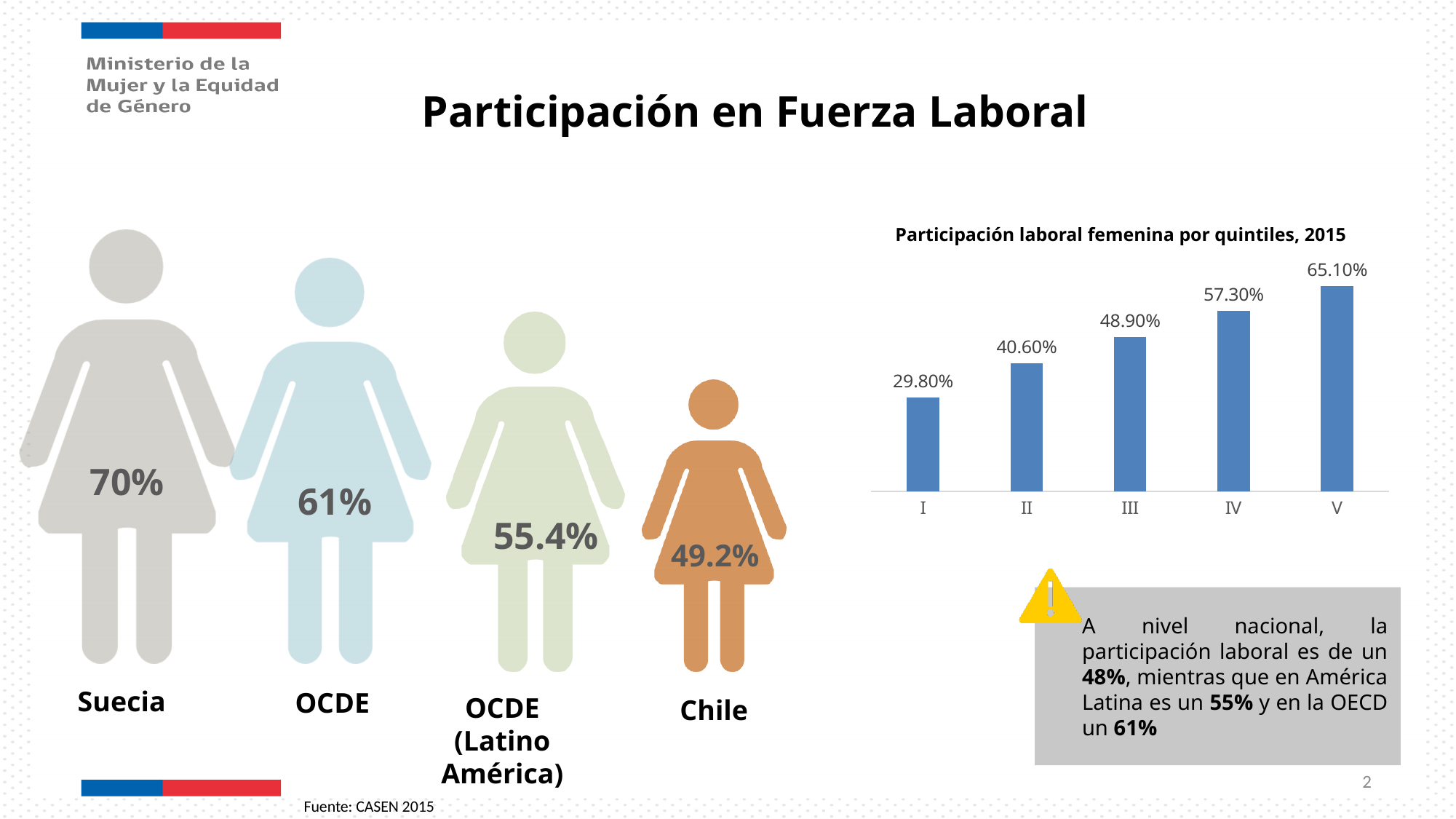
In the chart 'Participación laboral femenina por quintiles, 2015', do the values rise or fall from quintile I to quintile V? Rise In the chart 'Participación laboral femenina por quintiles, 2015', what is the value for quintile I? 29.80% What kind of chart is 'Participación laboral femenina por quintiles, 2015'? Bar chart In the chart 'Participación laboral femenina por quintiles, 2015', which is larger, quintile II or quintile IV? IV How many quintiles are shown in the chart 'Participación laboral femenina por quintiles, 2015'? 5 In the chart 'Participación laboral femenina por quintiles, 2015', what is the difference between quintile IV and quintile II? 16.70% In the chart 'Participación laboral femenina por quintiles, 2015', what is the value for quintile III? 48.90% In the chart 'Participación laboral femenina por quintiles, 2015', which quintile has the lowest value? I What is the title of the bar chart on the right side of the slide? Participación laboral femenina por quintiles, 2015 In the chart 'Participación laboral femenina por quintiles, 2015', what is the difference between quintile V and quintile I? 35.30% In the chart 'Participación laboral femenina por quintiles, 2015', which quintile has the highest value? V In the chart 'Participación laboral femenina por quintiles, 2015', what is the value for quintile V? 65.10%